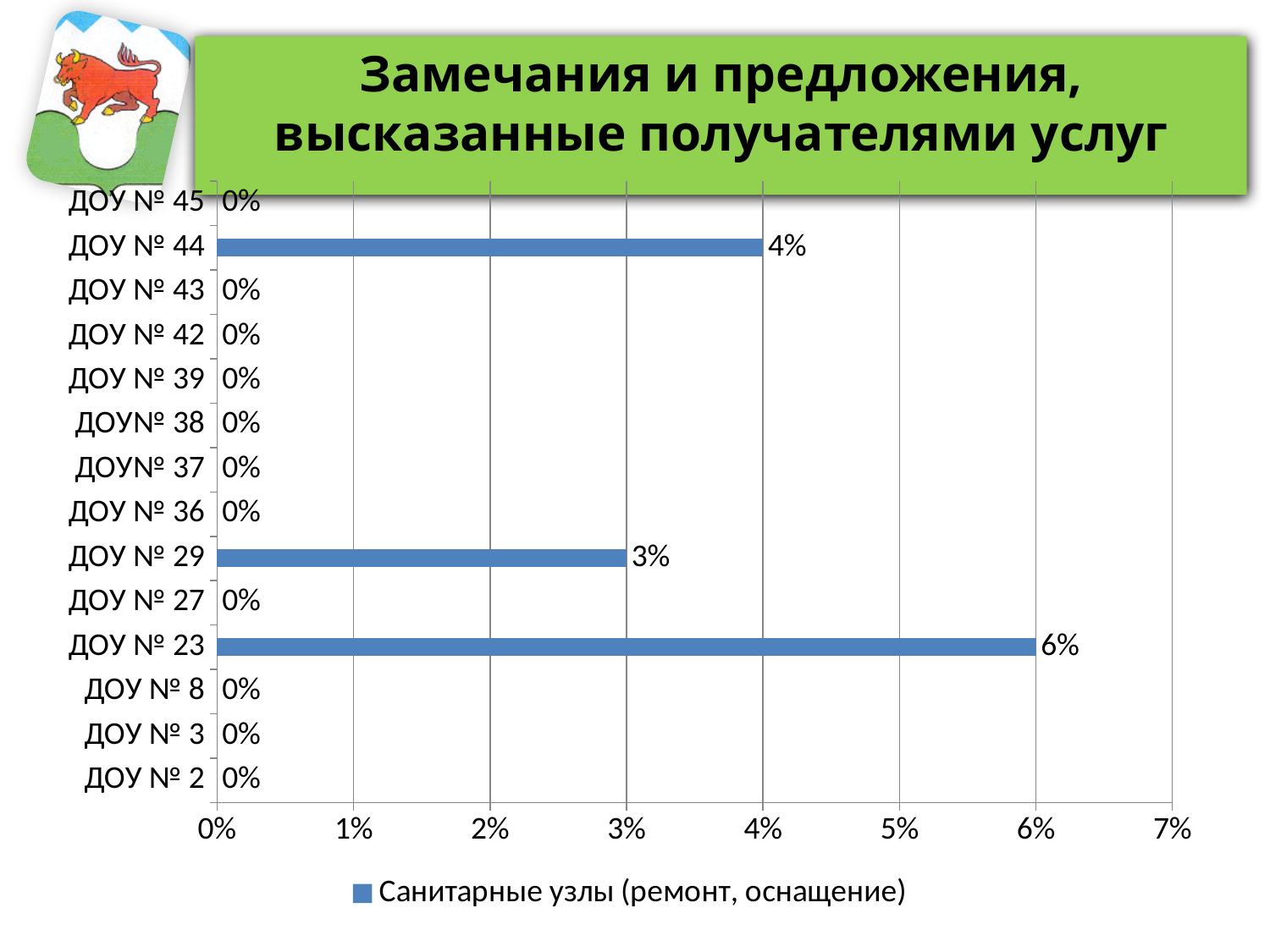
How many series does the legend list? 1 What is the difference between the values for ДОУ № 23 and ДОУ № 44? 2% What value is shown for ДОУ № 36? 0% What value is shown for ДОУ № 23? 6% What kind of chart is shown on the slide? bar chart How many categories are shown on the chart? 14 Is the value for ДОУ № 23 greater or less than 5%? greater What value is shown for ДОУ № 29? 3% What value is shown for ДОУ № 44? 4% Which is larger, the value for ДОУ № 29 or the value for ДОУ № 44? ДОУ № 44 Which category has the highest value? ДОУ № 23 What is the difference between the values for ДОУ № 44 and ДОУ № 29? 1%